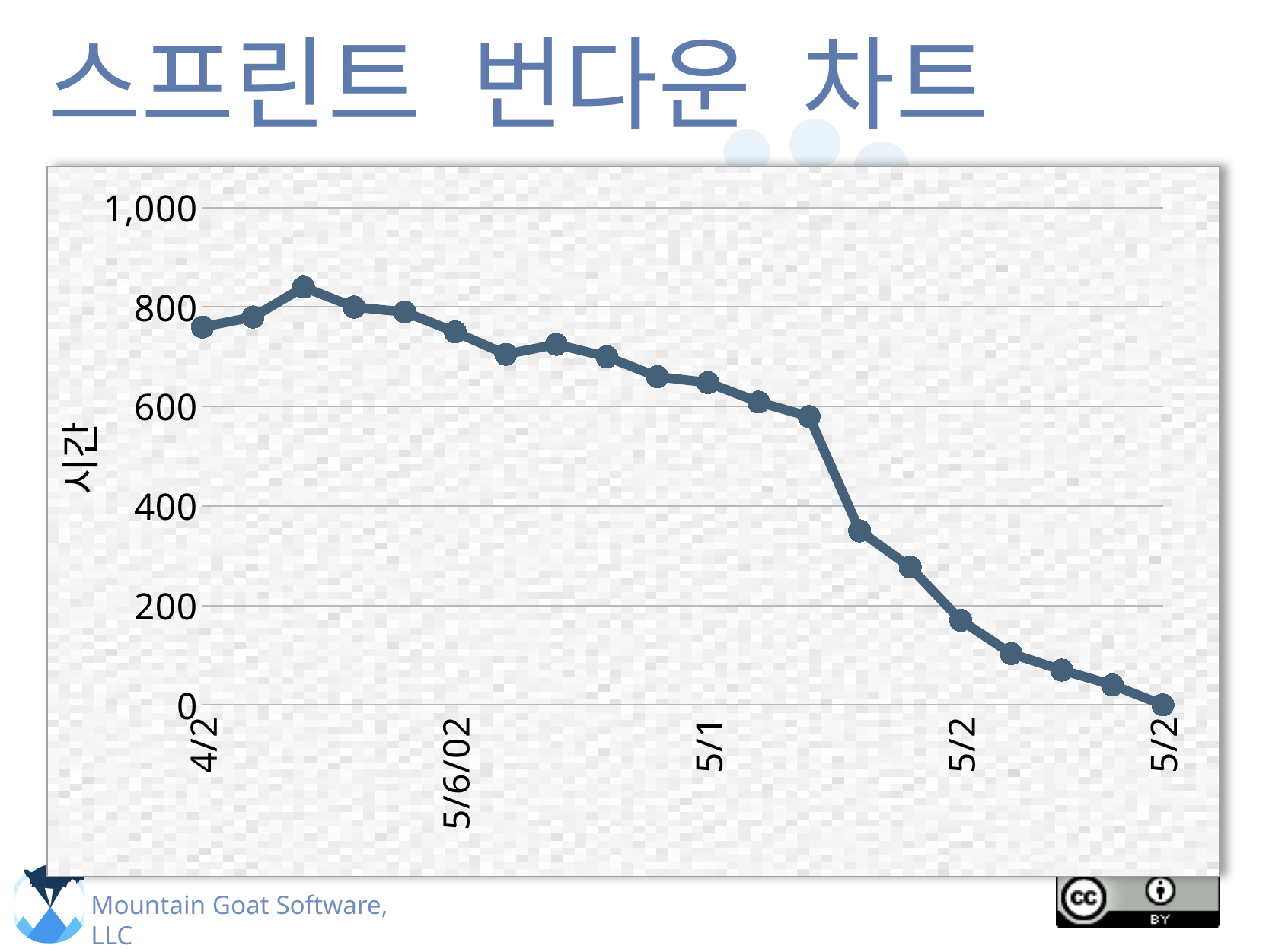
Do the values generally rise or fall along the x axis? fall Is the highest point on the line greater or less than 800? greater Which is larger, the value of the first data point or the value of the last data point? the first data point What kind of chart is shown on the slide? line chart How many data points are plotted on the line? 20 Is the value at the point labelled 5/6/02 greater or less than 600? greater What is the label on the y axis? 시간 Is the value of the first data point greater or less than 600? greater What is the value of the last data point on the line? 0 What is the title of the slide? 스프린트 번다운 차트